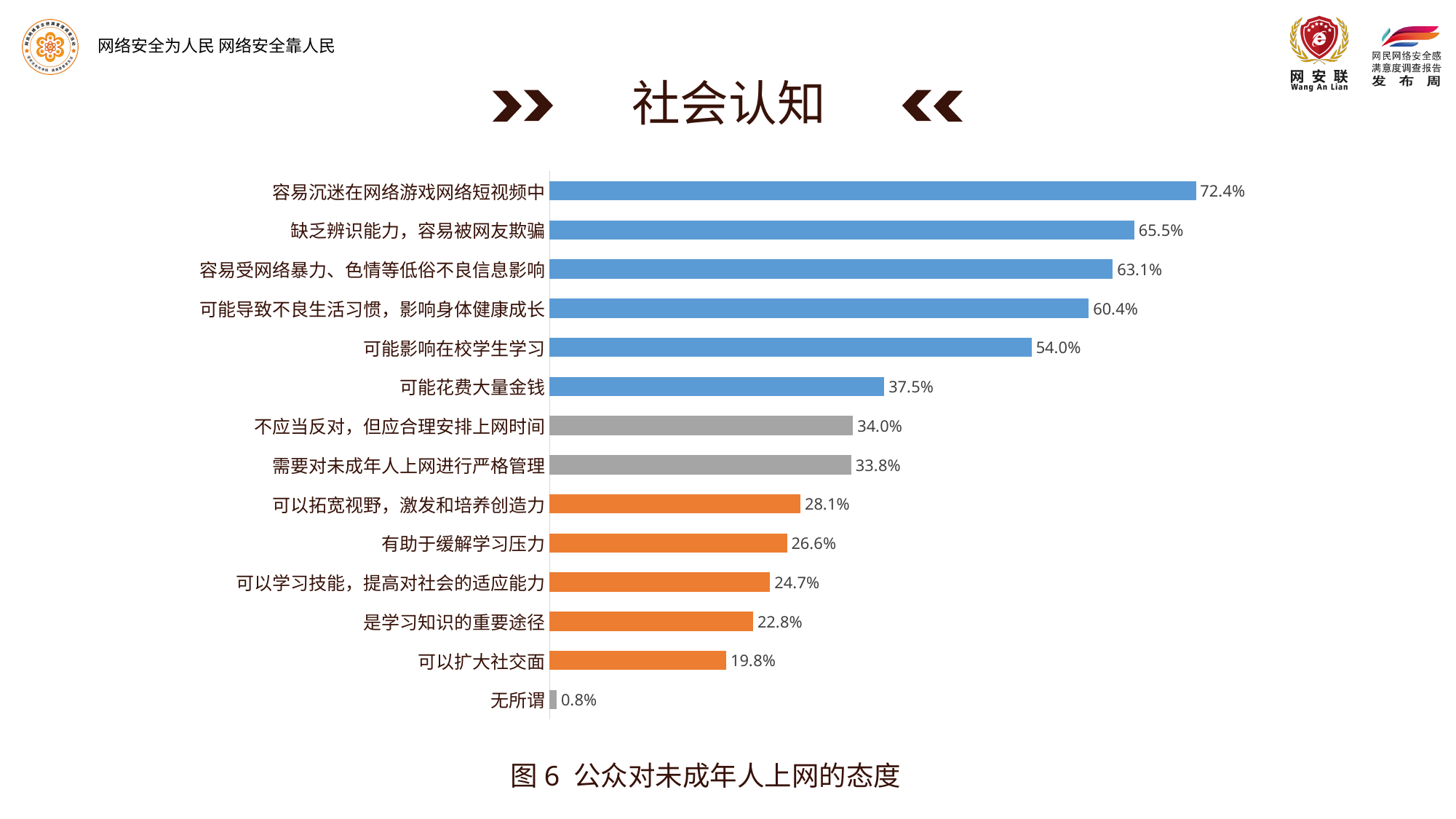
What is the value for 容易沉迷在网络游戏网络短视频中? 72.4% What is the value for 可能花费大量金钱? 37.5% What colour are the bars for 可以拓宽视野，激发和培养创造力 and 有助于缓解学习压力? Orange Which category has the highest value? 容易沉迷在网络游戏网络短视频中 What kind of chart is shown on the slide? Bar chart What is the value for 可以扩大社交面? 19.8% What is the value for 需要对未成年人上网进行严格管理? 33.8% How many categories are shown in the chart? 14 Which category has the lowest value? 无所谓 What is the difference between the values for 缺乏辨识能力，容易被网友欺骗 and 容易受网络暴力、色情等低俗不良信息影响? 2.4% What is the title of the chart? 图 6 公众对未成年人上网的态度 Which is larger, the value for 可能影响在校学生学习 or the value for 可能导致不良生活习惯，影响身体健康成长? 可能导致不良生活习惯，影响身体健康成长